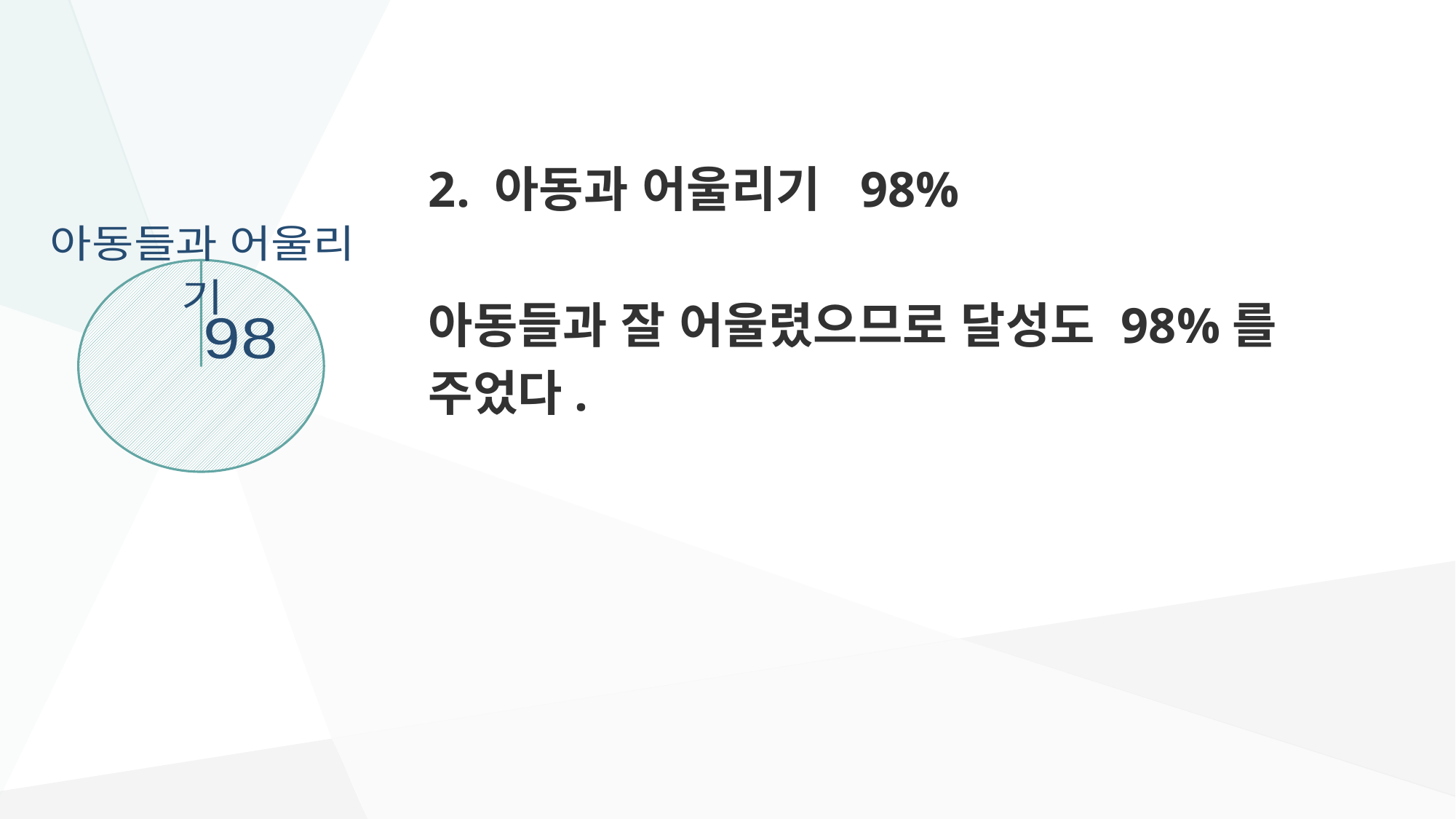
What value is printed as the data label on the large slice of the pie chart? 98 How many data labels are printed on the pie chart? 1 What is the title of the chart on the slide? 아동들과 어울리기 What kind of chart is shown on the slide? pie chart